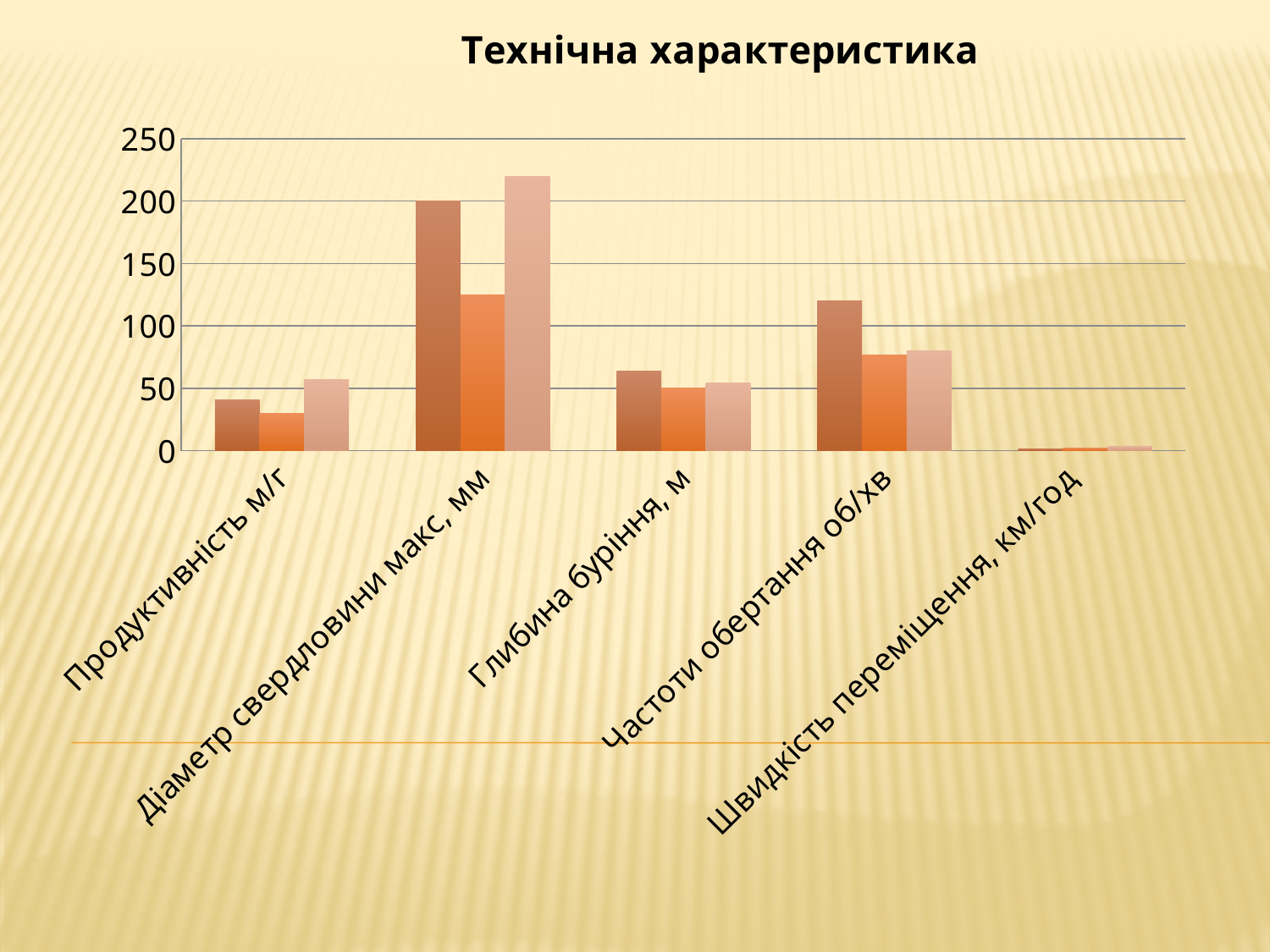
Which category has the tallest bar in the chart? Діаметр свердловини макс, мм Is the value of the first (dark brown) bar for Частоти обертання об/хв greater or less than 100? greater How many categories are shown on the x axis of the chart? 5 Which is taller: the first (dark brown) bar for Глибина буріння, м or the first (dark brown) bar for Частоти обертання об/хв? Частоти обертання об/хв What kind of chart is shown on the slide? bar chart Is the value of the third (light) bar for Діаметр свердловини макс, мм greater or less than 200? greater What is the title of the chart? Технічна характеристика How many bars are plotted for each category in the chart? 3 Is the value of the first (dark brown) bar for Діаметр свердловини макс, мм greater or less than 150? greater Which category has the lowest bars in the chart? Швидкість переміщення, км/год For Діаметр свердловини макс, мм, which is taller: the first (dark brown) bar or the second (orange) bar? the first (dark brown) bar